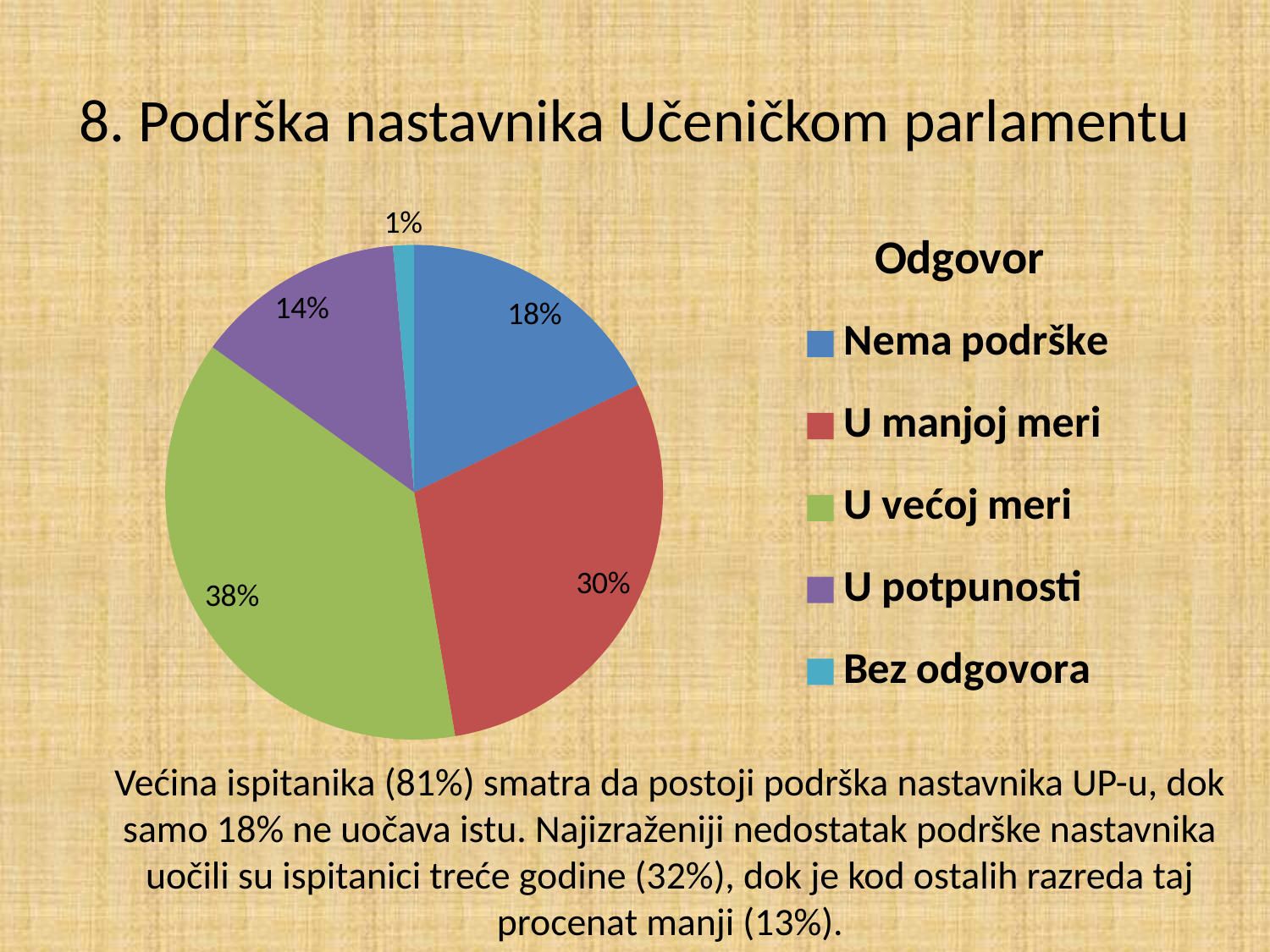
Which category has the smallest slice of the pie? Bez odgovora What is the title of the legend on the chart? Odgovor What share of the pie does "U potpunosti" represent? 14% What share of the pie does "U većoj meri" represent? 38% What is the difference between the shares of "U većoj meri" and "U manjoj meri"? 8% What share of the pie does "U manjoj meri" represent? 30% Which is larger, the share for "Nema podrške" or the share for "U potpunosti"? Nema podrške How many categories does the pie chart have? 5 Which category has the largest slice of the pie? U većoj meri What kind of chart is shown on the slide? pie chart